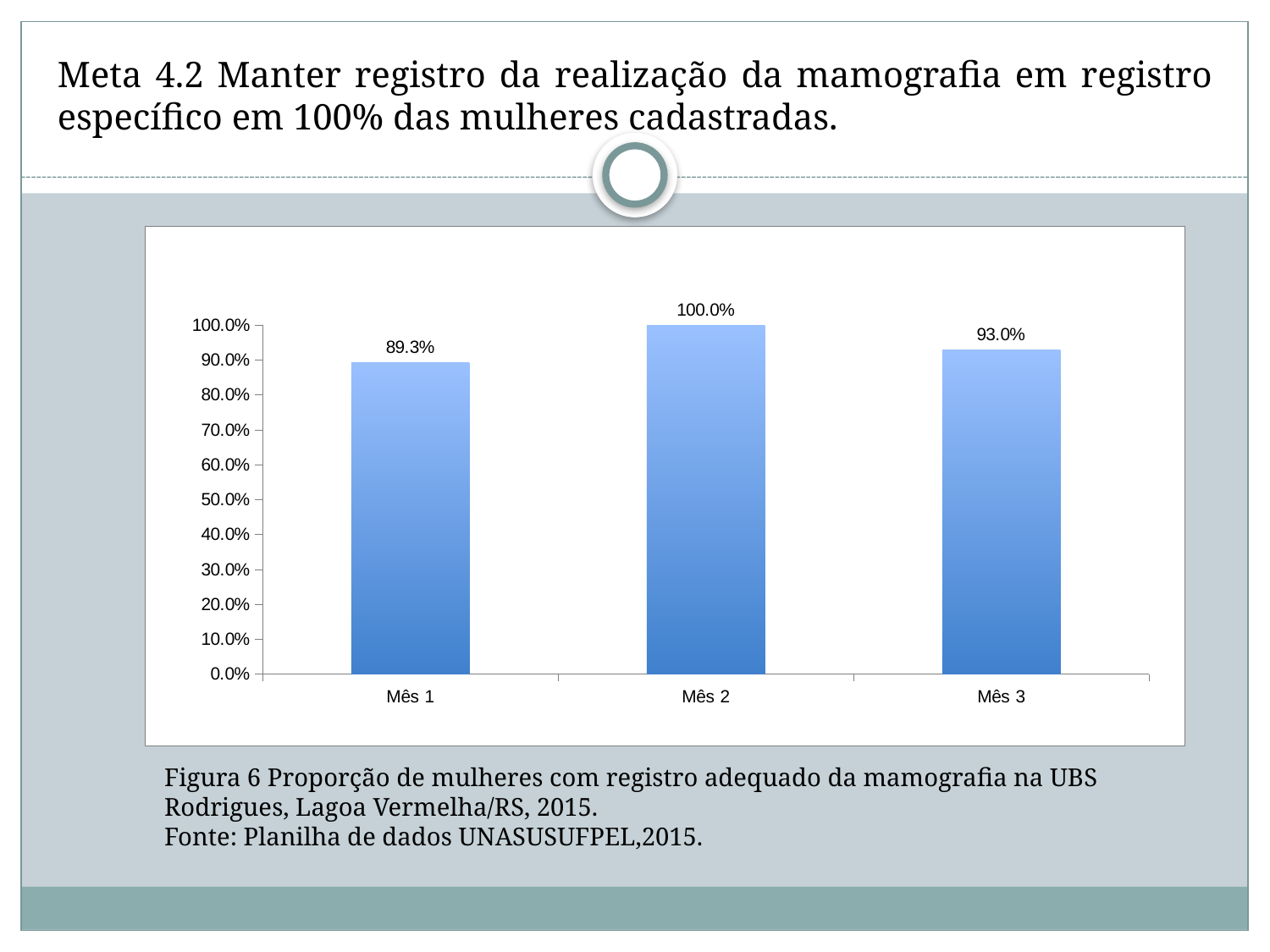
Which month has the lowest value? Mês 1 How many months are shown on the x axis? 3 Which month has the highest value? Mês 2 According to the caption, what figure number is this chart? Figura 6 What is the value for Mês 1? 89.3% What is the difference between the values for Mês 3 and Mês 1? 3.7% Is the value for Mês 1 greater or less than 80.0%? greater Which is larger, the value for Mês 3 or the value for Mês 1? Mês 3 What is the value for Mês 3? 93.0% What is the value for Mês 2? 100.0% What is the difference between the values for Mês 2 and Mês 1? 10.7% What kind of chart is shown on the slide? bar chart